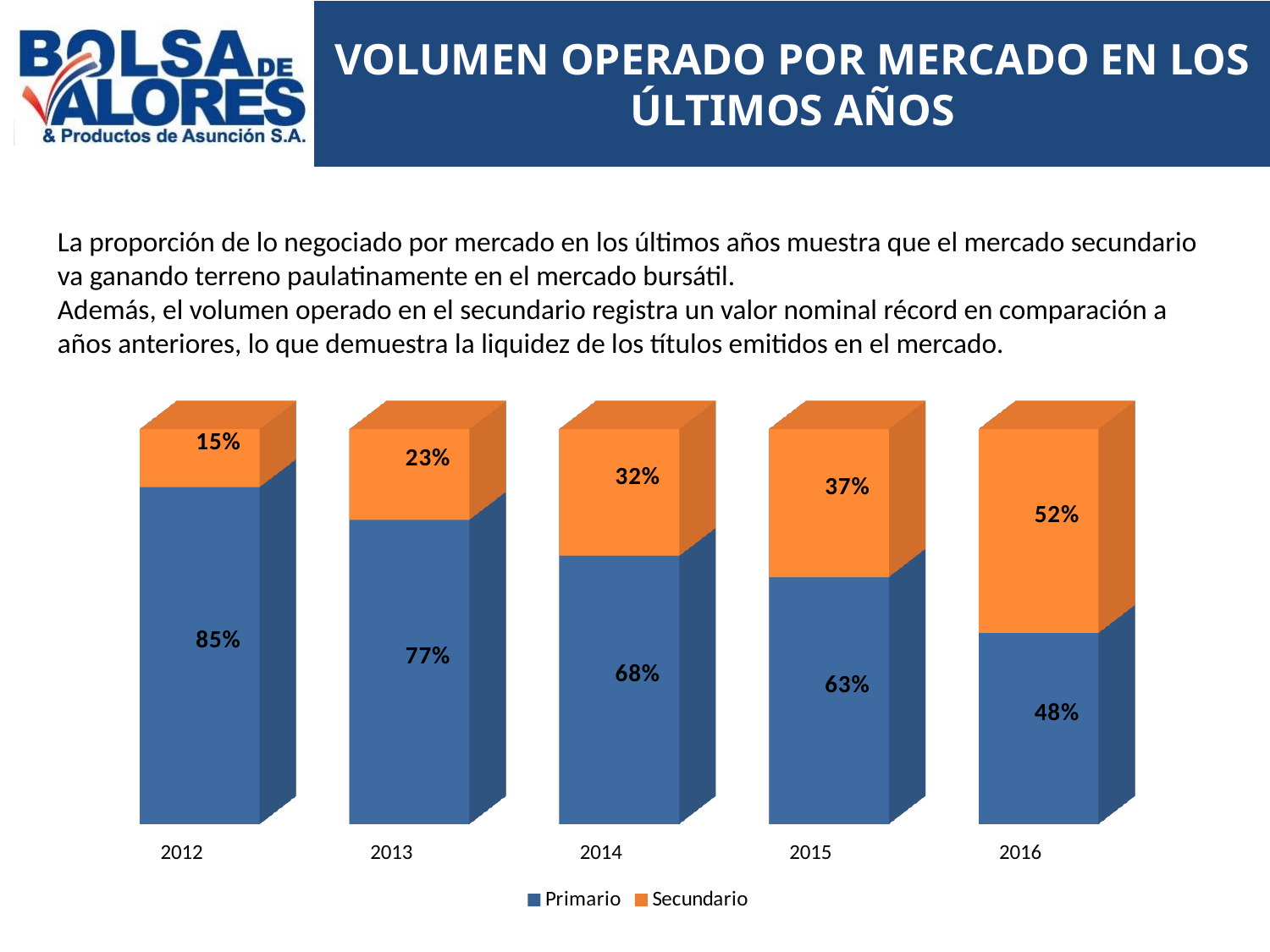
Which is larger in 2016, Primario or Secundario? Secundario How many years are shown on the x axis? 5 In which year is the Secundario value highest? 2016 What is the value for Primario in 2012? 85% What is the value for Primario in 2015? 63% Does the Secundario value rise or fall from 2012 to 2016? Rise What kind of chart is shown on the slide? Stacked bar chart How many series does the legend list? 2 In which year is the Primario value lowest? 2016 What is the value for Secundario in 2014? 32% What is the value for Secundario in 2016? 52% What is the difference between the Primario and Secundario values in 2013? 54%